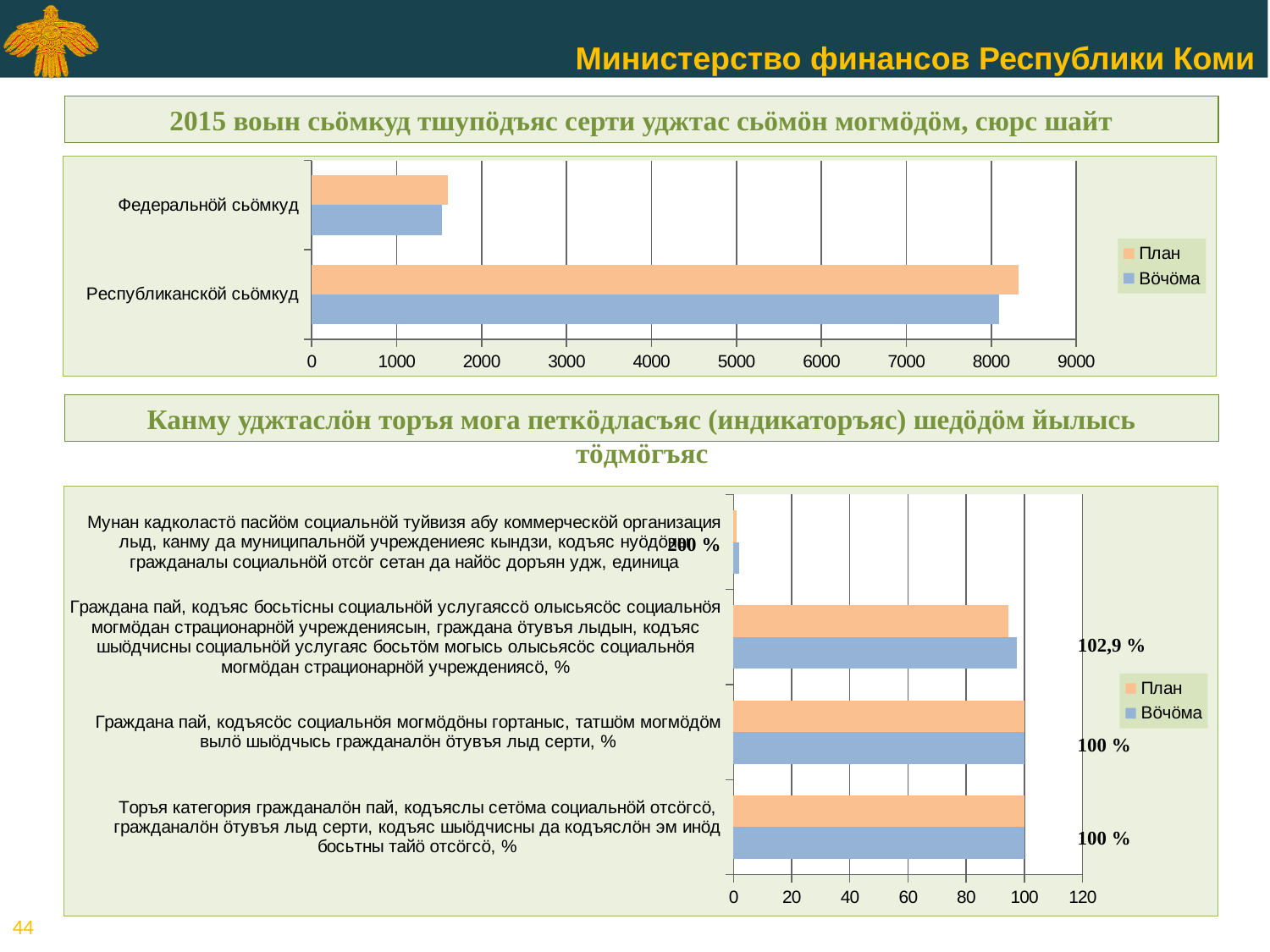
How many categories are shown in the bottom chart? 4 In the top chart, which is larger: the Вöчöма value for Республиканскöй сьöмкуд or the Вöчöма value for Федеральнöй сьöмкуд? Республиканскöй сьöмкуд In the top chart, is the План value for Федеральнöй сьöмкуд greater or less than 2000? less In the top chart, which category has the highest План value? Республиканскöй сьöмкуд In the bottom chart, is the План value for the category beginning 'Граждана пай, кодъяс босьтісны социальнöй услугаяссö' greater or less than 100? less In the top chart, is the Вöчöма value for Федеральнöй сьöмкуд greater or less than 1000? greater What kind of chart is the bottom chart on the slide? bar chart How many categories are shown in the top chart? 2 How many series does the legend of the top chart list? 2 What kind of chart is the top chart on the slide? bar chart In the bottom chart, which category has the lowest План value? Мунан кадколастö пасйöм социальнöй туйвизя абу коммерческöй организация лыд, канму да муниципальнöй учреждениеяс кындзи, кодъяс нуöдöны гражданалы социальнöй отсöг сетан да найöс доръян удж, единица